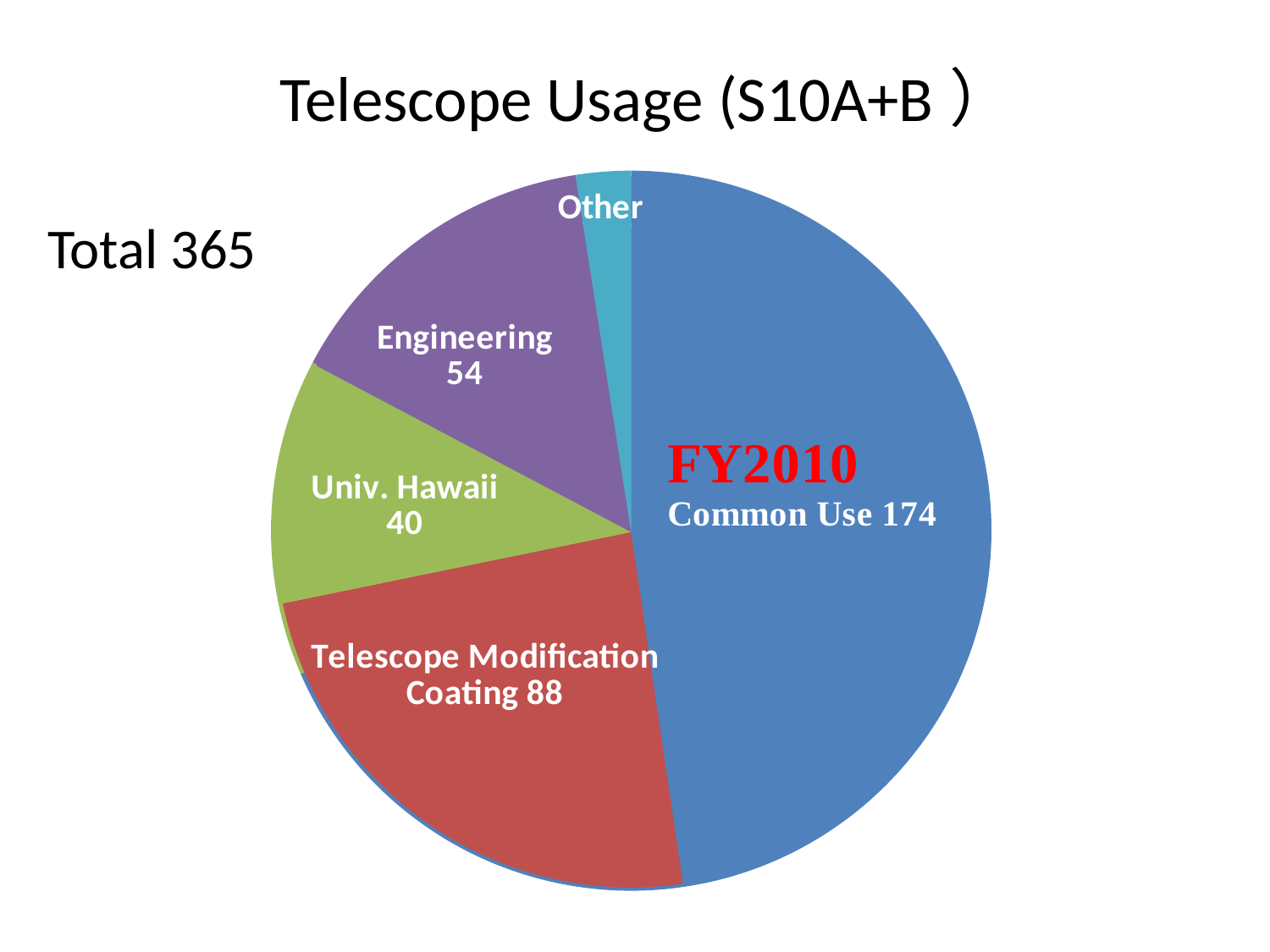
Which category has the smallest slice of the pie? Other How many slices does the pie chart have? 5 What type of chart is shown on the slide? Pie chart What is the difference between Engineering and Univ. Hawaii? 14 What total is stated on the slide for the pie chart? 365 What is the value for Telescope Modification Coating? 88 What is the difference between Common Use and Telescope Modification Coating? 86 What is the value for Univ. Hawaii? 40 What is the value for Common Use in the Telescope Usage pie chart? 174 Which is larger, Engineering or Univ. Hawaii? Engineering What is the value for Engineering? 54 Which category has the largest slice of the pie? Common Use